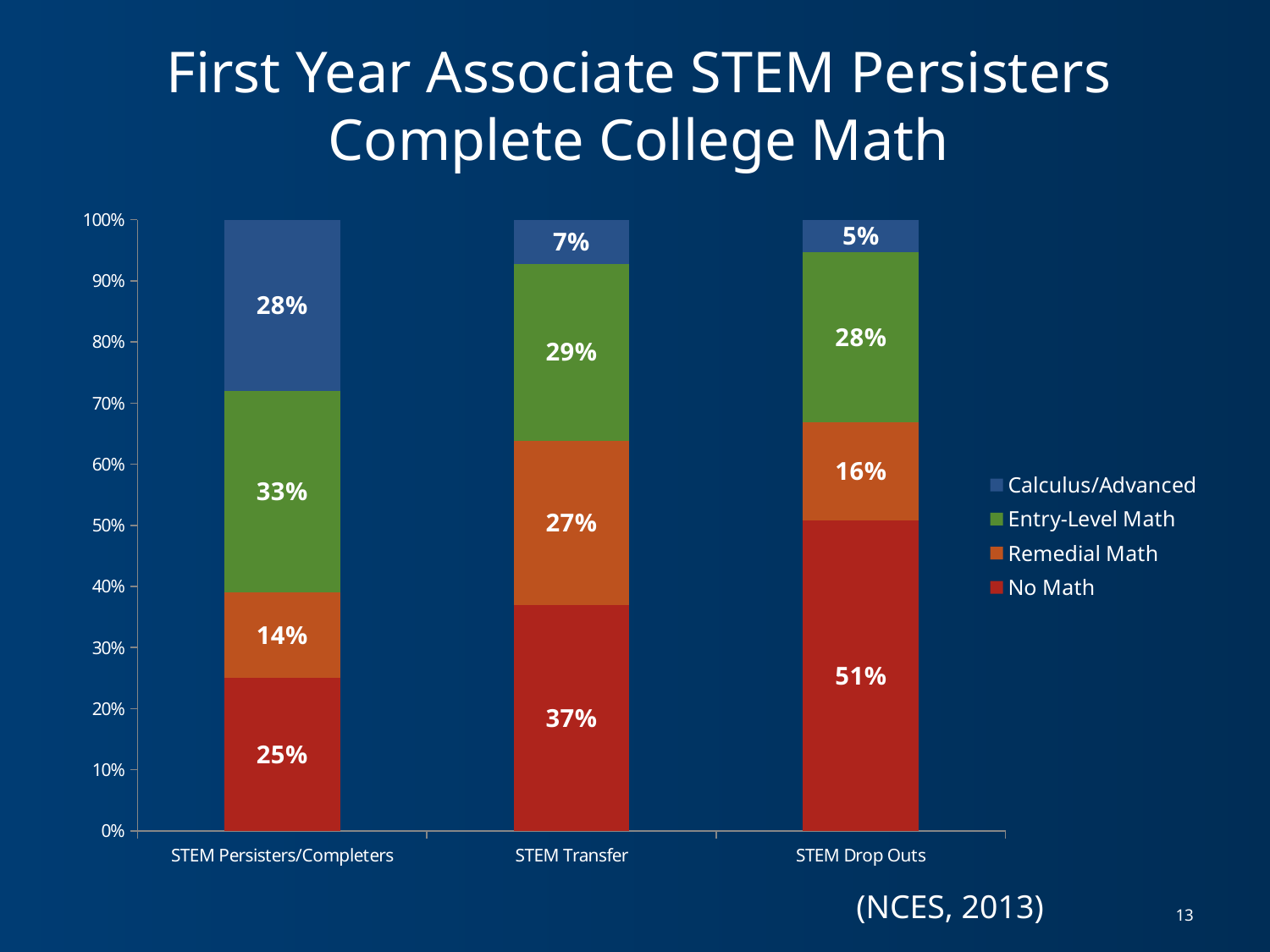
What kind of chart is shown on the slide? Stacked bar chart What is the title of the chart? First Year Associate STEM Persisters Complete College Math What is the value for Calculus/Advanced in the STEM Transfer bar? 7% How many categories are shown on the x axis? 3 How many series does the legend list? 4 What is the value for Remedial Math in the STEM Persisters/Completers bar? 14% What is the value for No Math in the STEM Drop Outs bar? 51% Which category has the lowest Calculus/Advanced value? STEM Drop Outs Which category has the highest No Math value? STEM Drop Outs What is the difference between the No Math values for STEM Drop Outs and STEM Persisters/Completers? 26 percentage points Does the No Math value rise or fall from STEM Persisters/Completers to STEM Drop Outs? Rise Which has the larger Entry-Level Math value, STEM Persisters/Completers or STEM Transfer? STEM Persisters/Completers